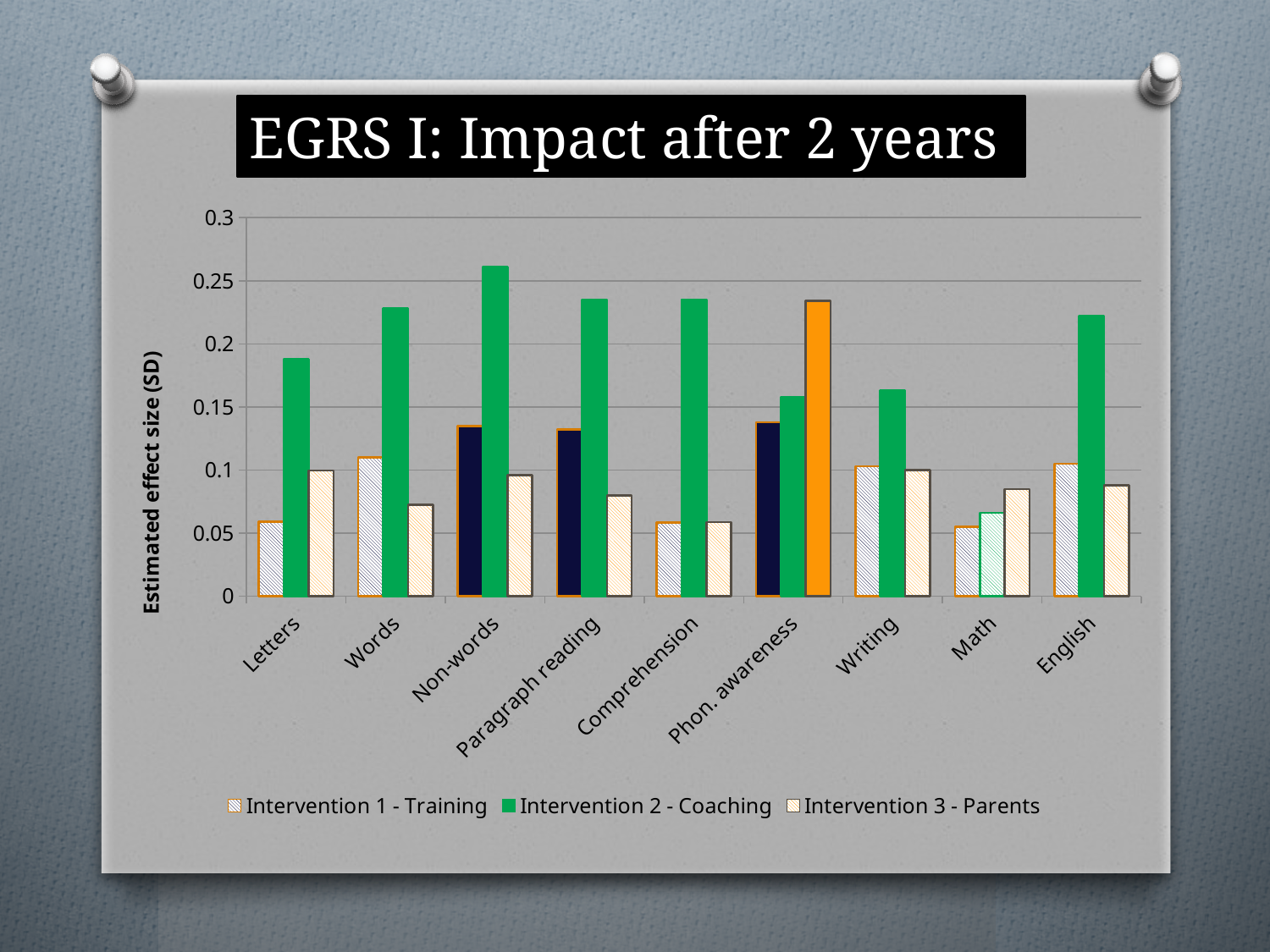
Is the value for Intervention 1 - Training in Letters greater or less than 0.1? less How many series does the legend list? 3 Which category has the lowest value for Intervention 2 - Coaching? Math Is the value for Intervention 2 - Coaching in Letters greater or less than 0.15? greater How many categories are shown along the x axis? 9 Is the value for Intervention 3 - Parents in Phon. awareness greater or less than 0.2? greater In Phon. awareness, which is larger: Intervention 2 - Coaching or Intervention 3 - Parents? Intervention 3 - Parents Which category has the highest value for Intervention 2 - Coaching? Non-words In Words, which is larger: Intervention 1 - Training or Intervention 3 - Parents? Intervention 1 - Training What is the label of the vertical axis? Estimated effect size (SD) What kind of chart is shown on the slide? bar chart